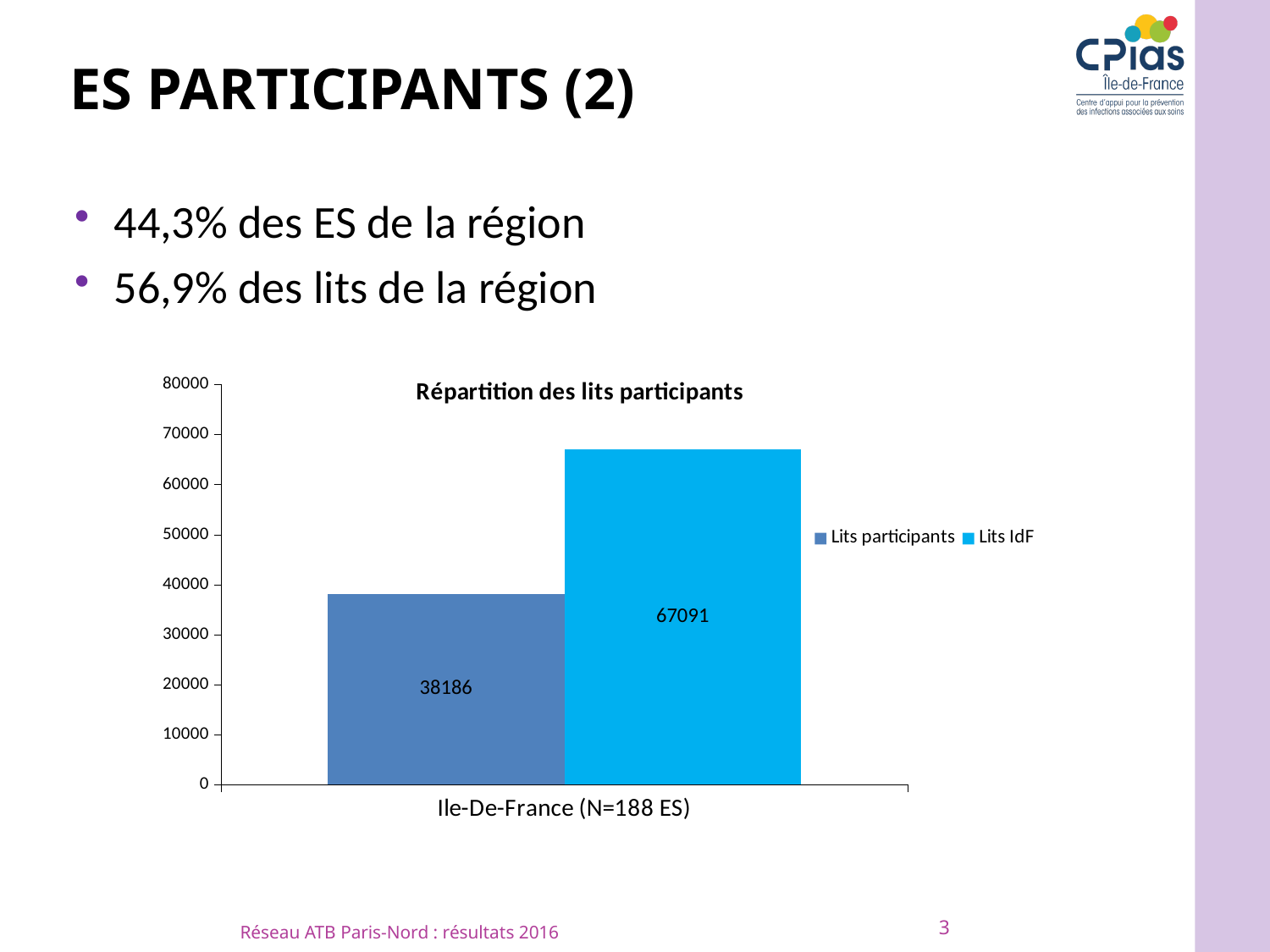
Is the value for Lits participants greater or less than 40000? less What is the value of the Lits IdF bar? 67091 How many categories are shown on the x axis? 1 Which series has the lowest value in the chart? Lits participants What type of chart is shown on the slide? bar chart Which series has the higher value, Lits participants or Lits IdF? Lits IdF What is the label of the category on the x axis? Ile-De-France (N=188 ES) What is the difference between the Lits IdF value and the Lits participants value? 28905 Is the value for Lits IdF greater or less than 60000? greater What is the title of the chart? Répartition des lits participants How many series does the legend list? 2 What is the value of the Lits participants bar? 38186